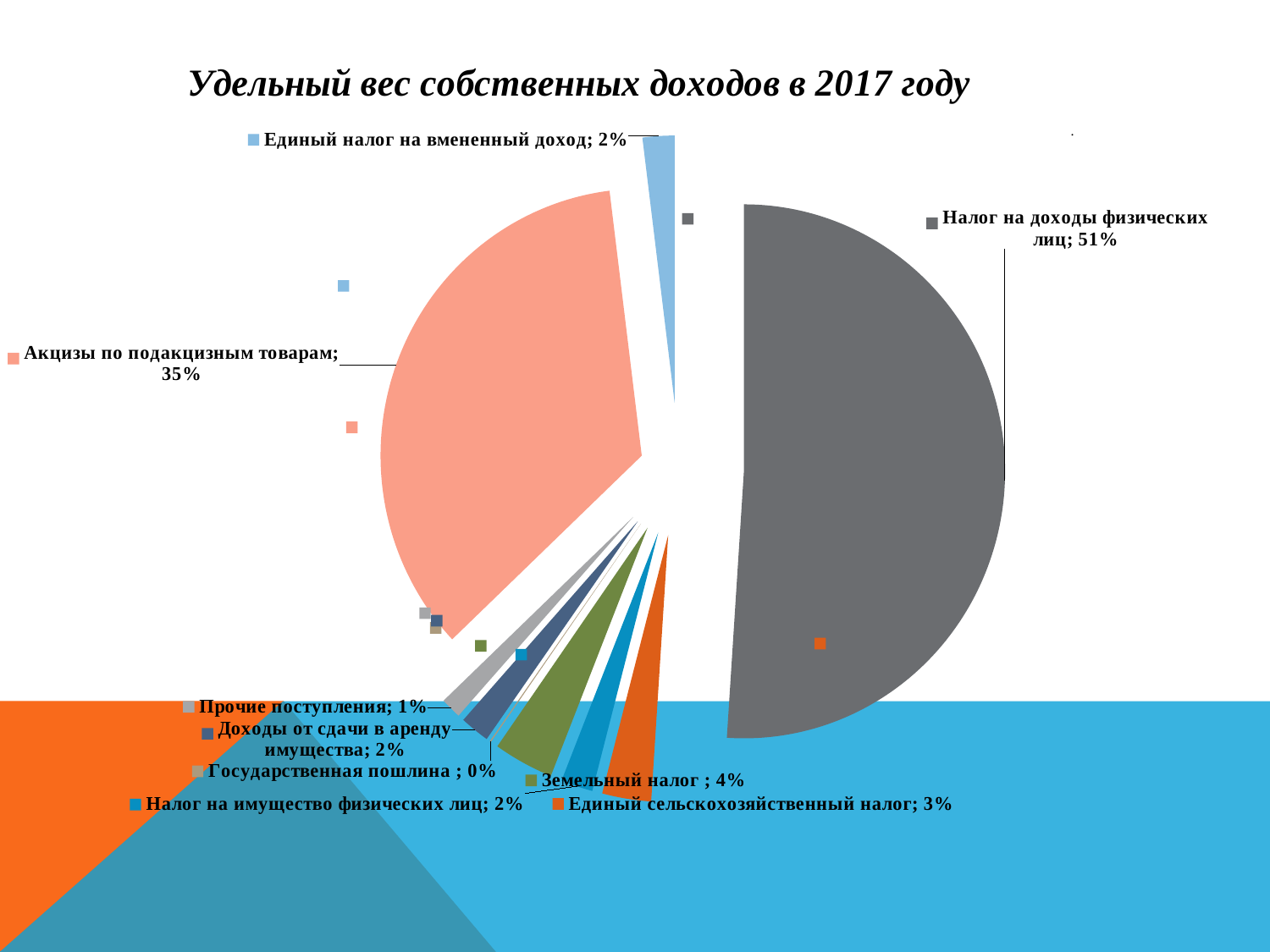
What is the title of the chart? Удельный вес собственных доходов в 2017 году What is the difference between the shares of Налог на доходы физических лиц and Акцизы по подакцизным товарам? 16% What is the value shown for Государственная пошлина? 0% What kind of chart is shown on the slide? pie chart Which is larger: the share of Земельный налог or the share of Единый сельскохозяйственный налог? Земельный налог How many categories are shown in the pie chart? 9 What share does Акцизы по подакцизным товарам have in the pie? 35% Which category has the largest share of the pie? Налог на доходы физических лиц What share does Налог на доходы физических лиц have in the pie? 51% What is the value shown for Земельный налог? 4% Which category has the smallest share of the pie? Государственная пошлина What is the value shown for Единый сельскохозяйственный налог? 3%